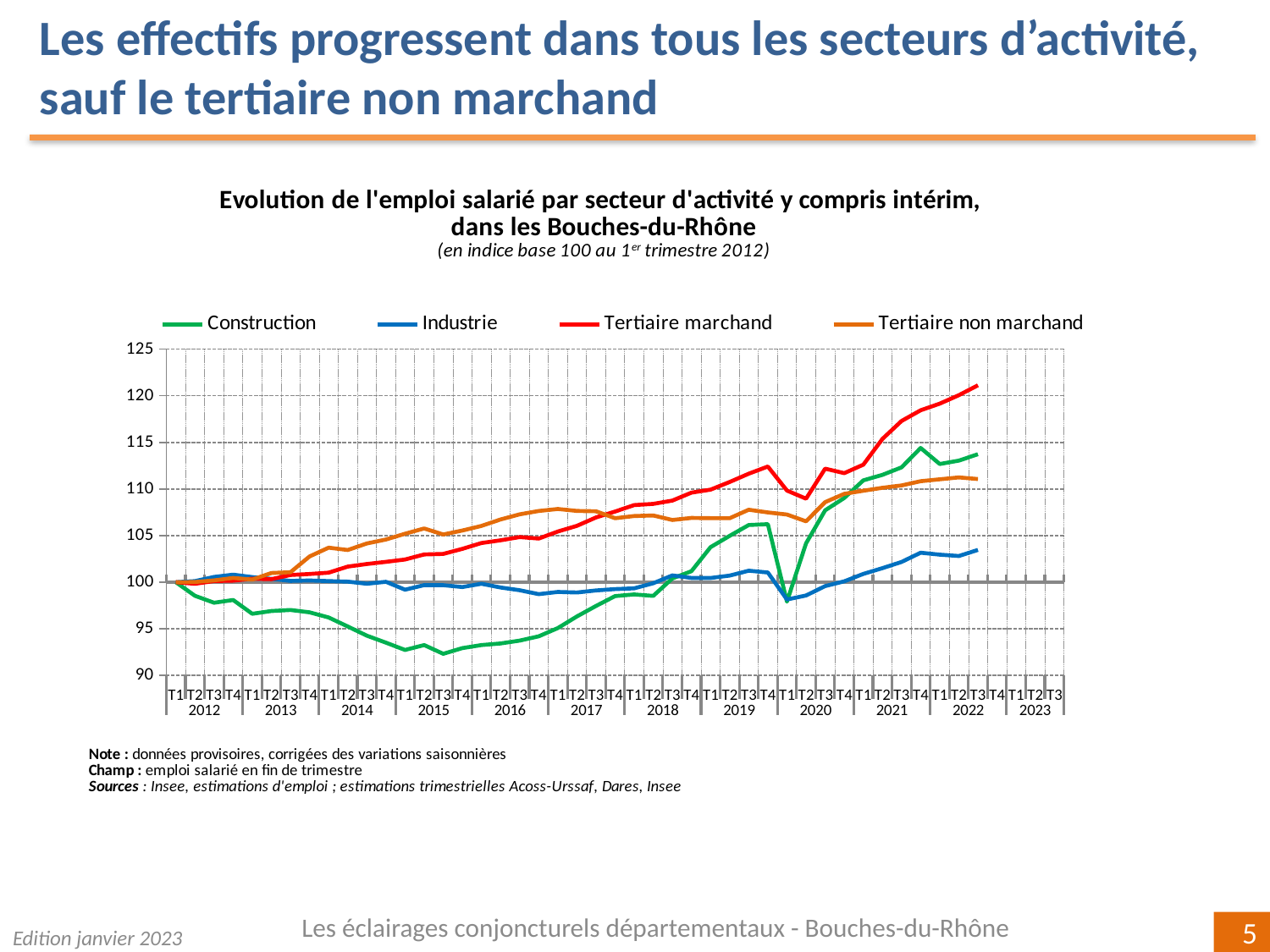
How many series does the legend list? 4 Is the value for Industrie at T3 2022 greater or less than 100? greater Does the Construction series rise or fall between T1 2012 and T3 2015? fall What kind of chart is shown on the slide? line chart Which series has the highest value at T3 2022? Tertiaire marchand What is the index value of all four series at T1 2012? 100 Which series has the lowest value at T3 2022? Industrie What is the title of the chart? Evolution de l'emploi salarié par secteur d'activité y compris intérim, dans les Bouches-du-Rhône Which colour is used for the Construction series? green Is the value for Tertiaire marchand at T3 2022 greater or less than 115? greater At T3 2022, which is higher: Tertiaire marchand or Tertiaire non marchand? Tertiaire marchand Is the value for Construction at T3 2015 greater or less than 95? less